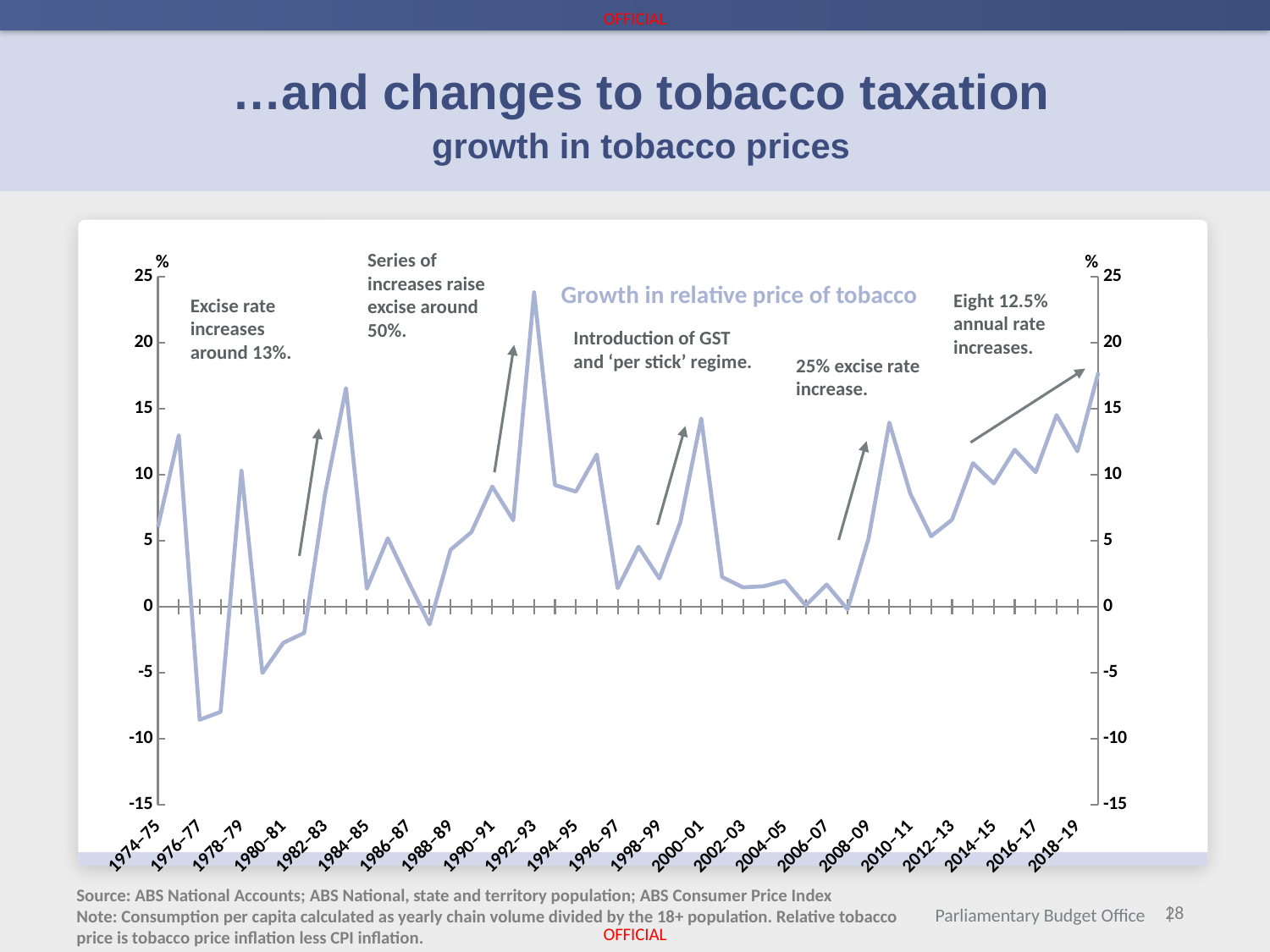
Is the value for 2012–13 greater or less than 10? less Which is larger, the value for 2018–19 or the value for 2012–13? 2018–19 What kind of chart is shown on the slide? line chart Is the value for 2018–19 greater or less than 15? less What unit is shown on the vertical axes of the chart? % Is the value for 1980–81 greater or less than 0? less Which is larger, the value for 1992–93 or the value for 1984–85? 1992–93 Which year has the highest growth in relative price of tobacco? 1992–93 What is the title printed inside the chart area? Growth in relative price of tobacco